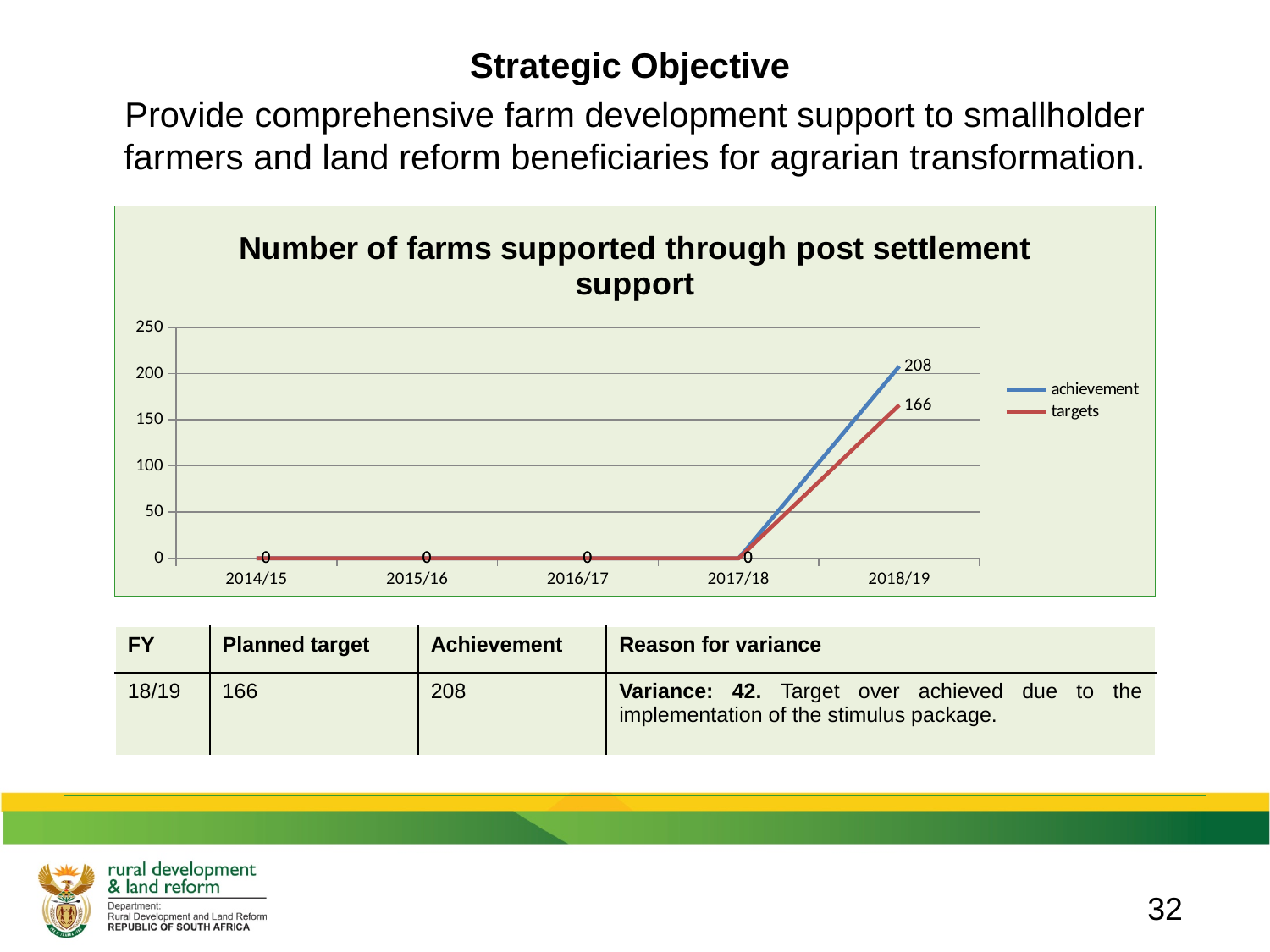
What is the achievement value for 2016/17? 0 What is the targets value for 2018/19? 166 How many fiscal years are shown on the x axis? 5 What is the difference between the achievement and targets values for 2018/19? 42 What kind of chart is shown? line chart Does the achievement line rise or fall between 2017/18 and 2018/19? rise What is the title of the chart? Number of farms supported through post settlement support For 2018/19, which is larger: achievement or targets? achievement What is the achievement value for 2018/19? 208 How many series does the legend list? 2 Which fiscal year has the highest achievement value? 2018/19 Is the achievement value for 2018/19 greater or less than 200? greater